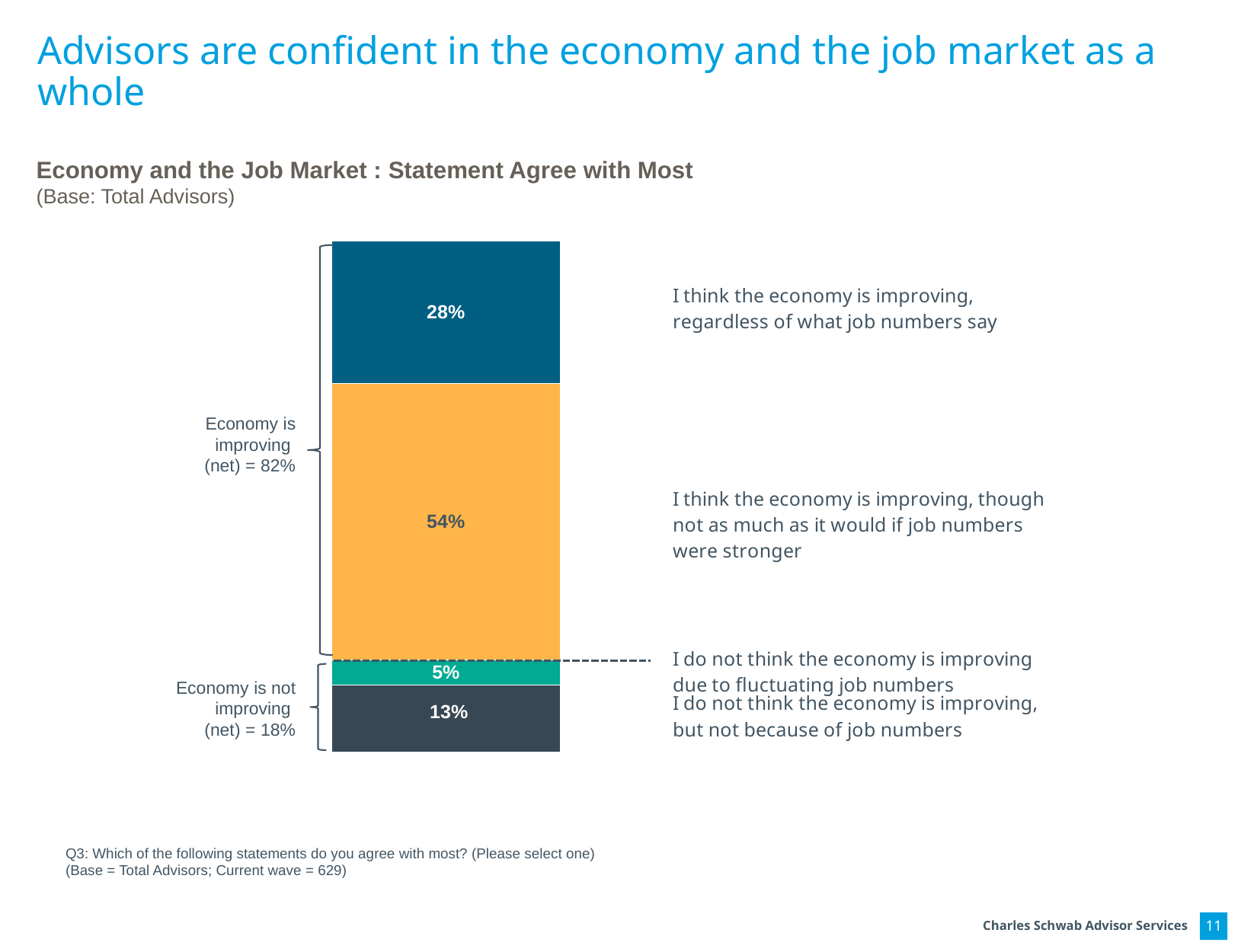
What is the net percentage of advisors who think the economy is not improving? 18% What type of chart is shown on the slide? Stacked bar chart What percentage of advisors agree most with the statement "I think the economy is improving, regardless of what job numbers say"? 28% How many segments make up the stacked bar? 4 What is the difference between the share for "improving, though not as much as it would if job numbers were stronger" and the share for "improving, regardless of what job numbers say"? 26 percentage points What percentage of advisors agree most with "I do not think the economy is improving, but not because of job numbers"? 13% Which is larger: the share for "I do not think the economy is improving, but not because of job numbers" or the share for "I do not think the economy is improving due to fluctuating job numbers"? I do not think the economy is improving, but not because of job numbers What is the net percentage of advisors who think the economy is improving? 82% Which statement has the largest share of advisors? I think the economy is improving, though not as much as it would if job numbers were stronger Which statement has the smallest share of advisors? I do not think the economy is improving due to fluctuating job numbers What percentage of advisors agree most with "I think the economy is improving, though not as much as it would if job numbers were stronger"? 54% What percentage of advisors agree most with "I do not think the economy is improving due to fluctuating job numbers"? 5%